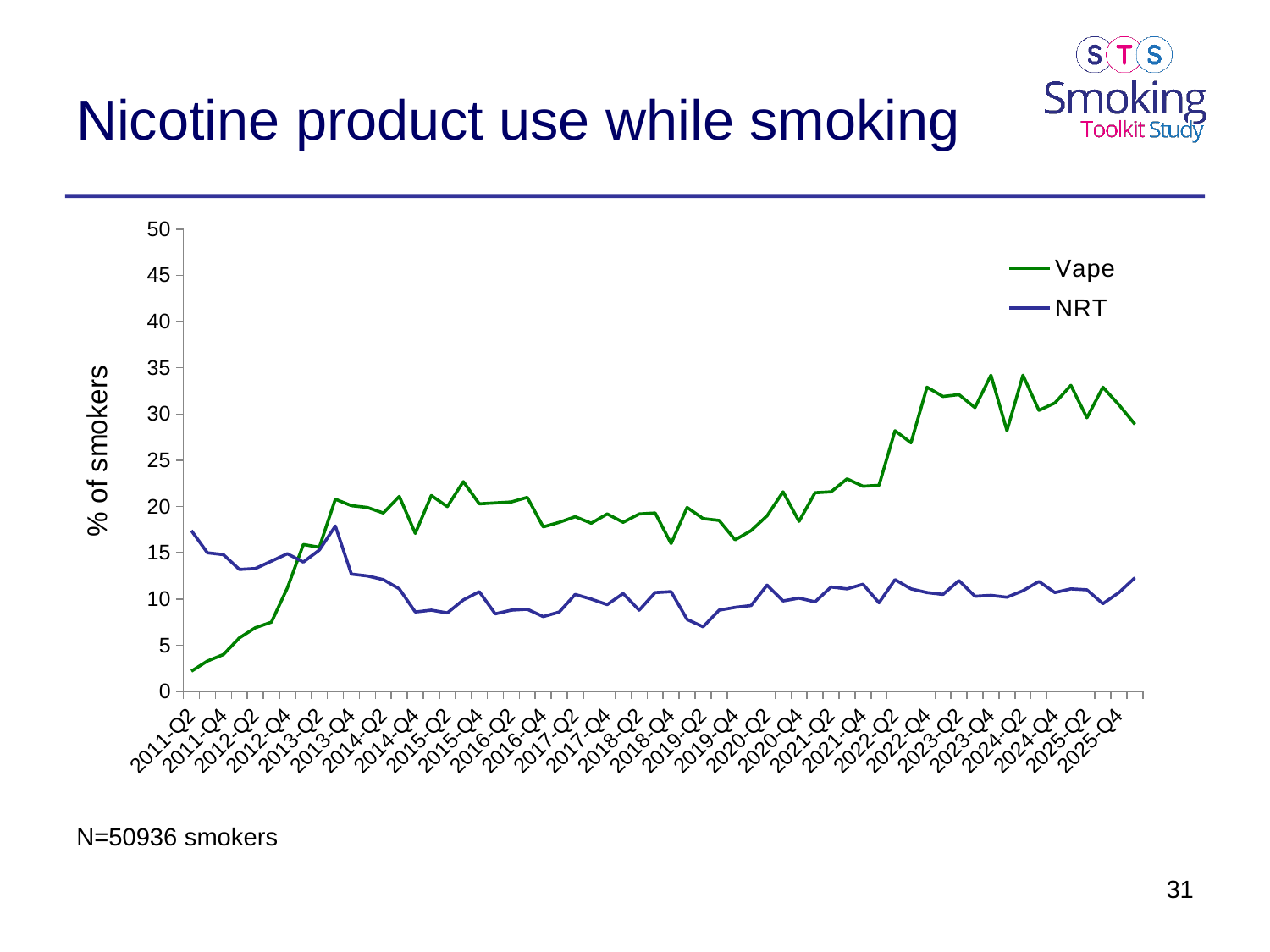
Is the value for Vape at 2011-Q2 greater or less than 5? less What kind of chart is shown on the slide? line chart Does the NRT series overall rise or fall from 2011-Q2 to 2025-Q4? fall Which series has the larger value at 2011-Q2, Vape or NRT? NRT Which series has the larger value at 2025-Q4, Vape or NRT? Vape Is the value for NRT at 2019-Q2 greater or less than 10? less How many series does the legend list? 2 Is the value for NRT at 2011-Q2 greater or less than 15? greater What is the title of the chart on the slide? Nicotine product use while smoking What is the label on the y axis of the chart? % of smokers Does the Vape series overall rise or fall from 2011-Q2 to 2025-Q4? rise